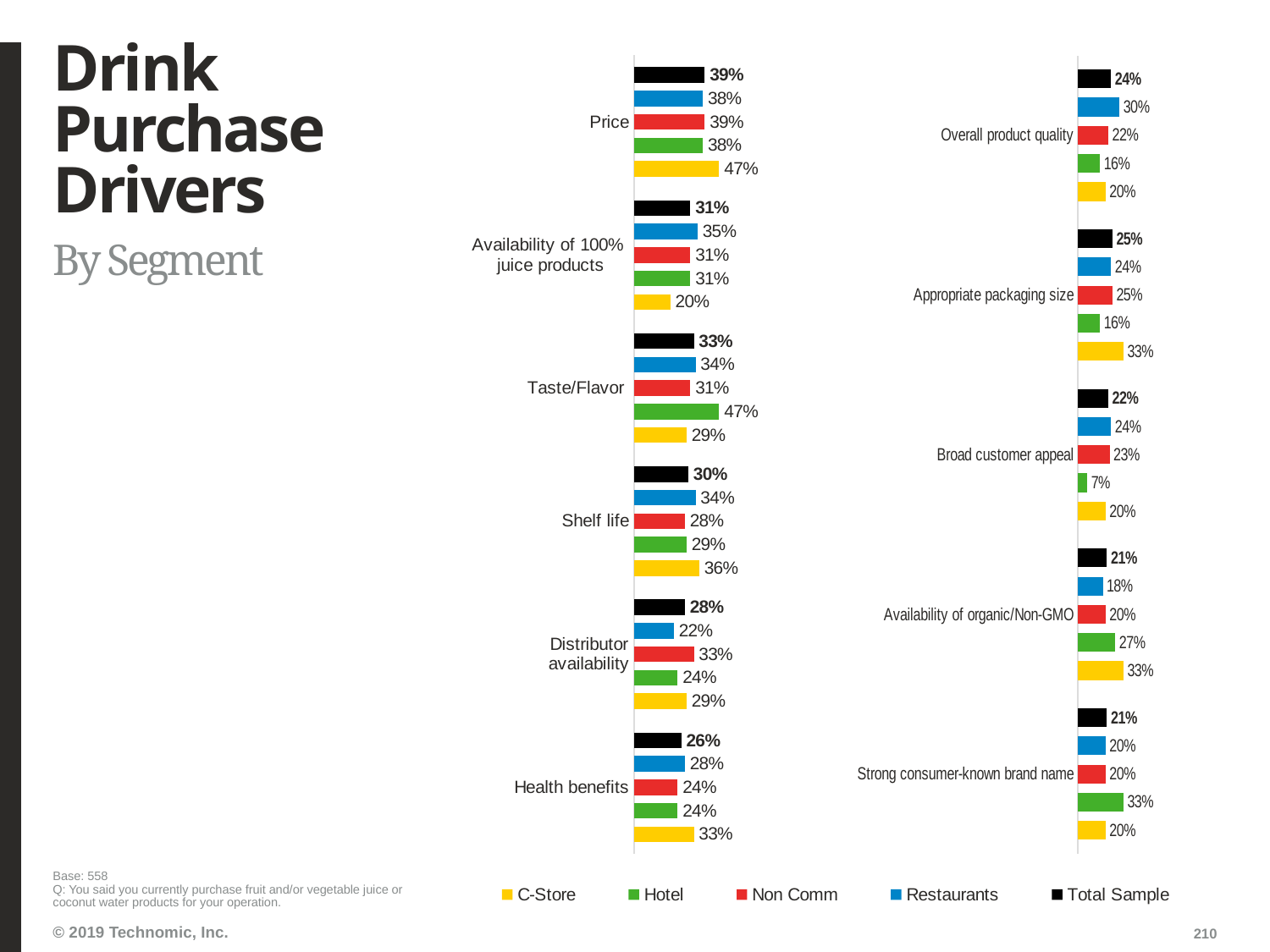
In the right chart, which category has the lowest Hotel value? Broad customer appeal In the left chart, which category has the highest Total Sample value? Price In the left chart, what is the difference between the C-Store and Restaurants values for Shelf life? 2% In the left chart, what is the Hotel value for Taste/Flavor? 47% In the right chart, what is the Hotel value for Broad customer appeal? 7% What type of chart is used on this slide? Bar chart In the right chart, which is larger for Availability of organic/Non-GMO: the C-Store value or the Restaurants value? C-Store How many categories are shown in the left chart? 6 In the left chart, what is the C-Store value for Price? 47% How many series does the legend list? 5 In the right chart, what is the Restaurants value for Overall product quality? 30% How many categories are shown in the right chart? 5